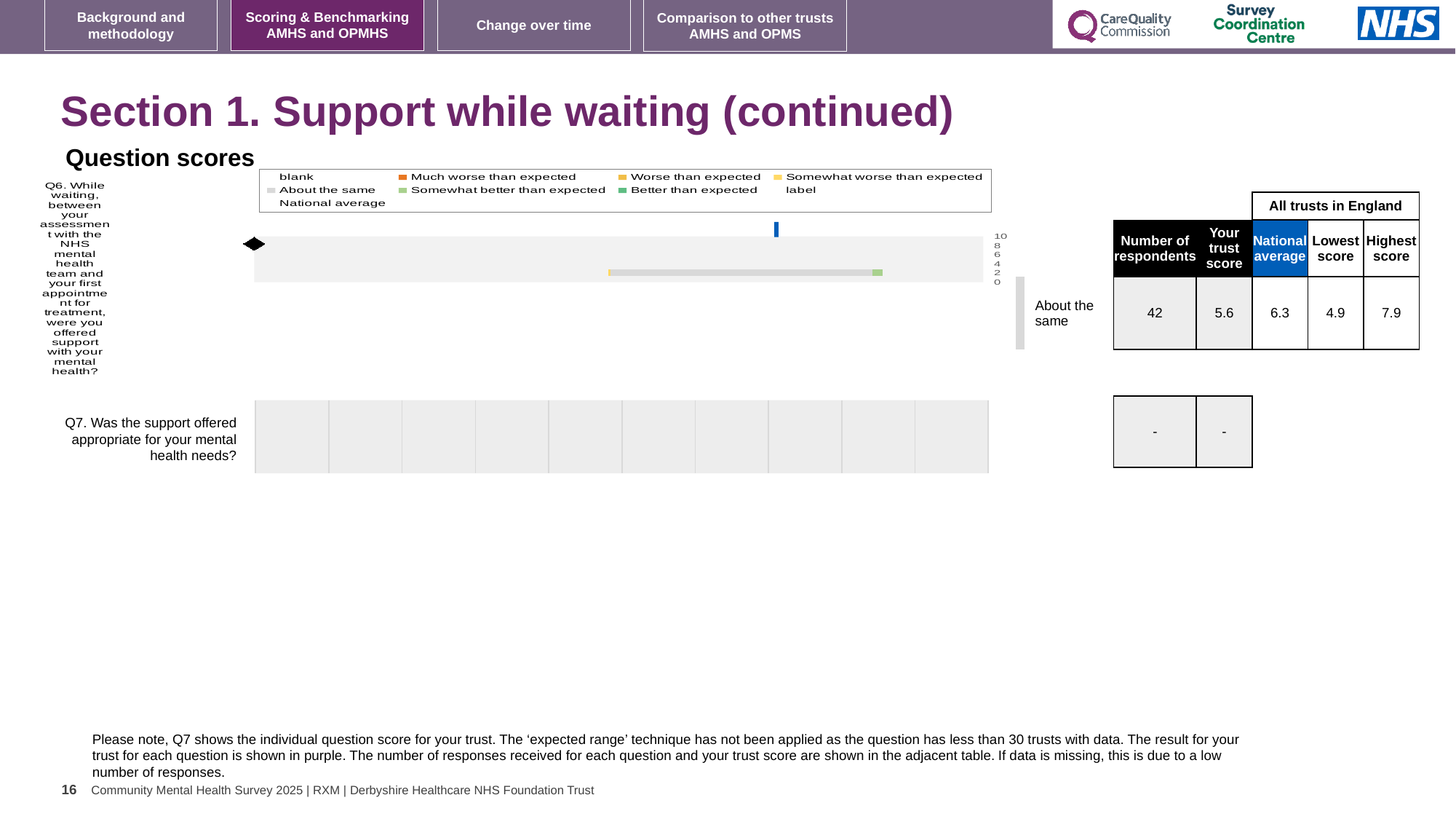
What is the difference between the national average and the trust score for Q6? 0.7 What is the lowest score among all trusts in England for Q6? 4.9 Is the trust score for Q6 higher or lower than the national average? lower How many respondents answered Q6? 42 What colour does the legend assign to 'Much worse than expected'? orange Which category is the Q6 trust score placed in, according to the label beside the chart? About the same What is the trust score for Q6 shown in the table next to the chart? 5.6 What is the highest score among all trusts in England for Q6? 7.9 What is the national average score for Q6? 6.3 What is the maximum value shown on the chart's score axis? 10 What kind of chart is used to show the Q6 question score? bar chart What is the difference between the highest and lowest scores for Q6 across all trusts in England? 3.0